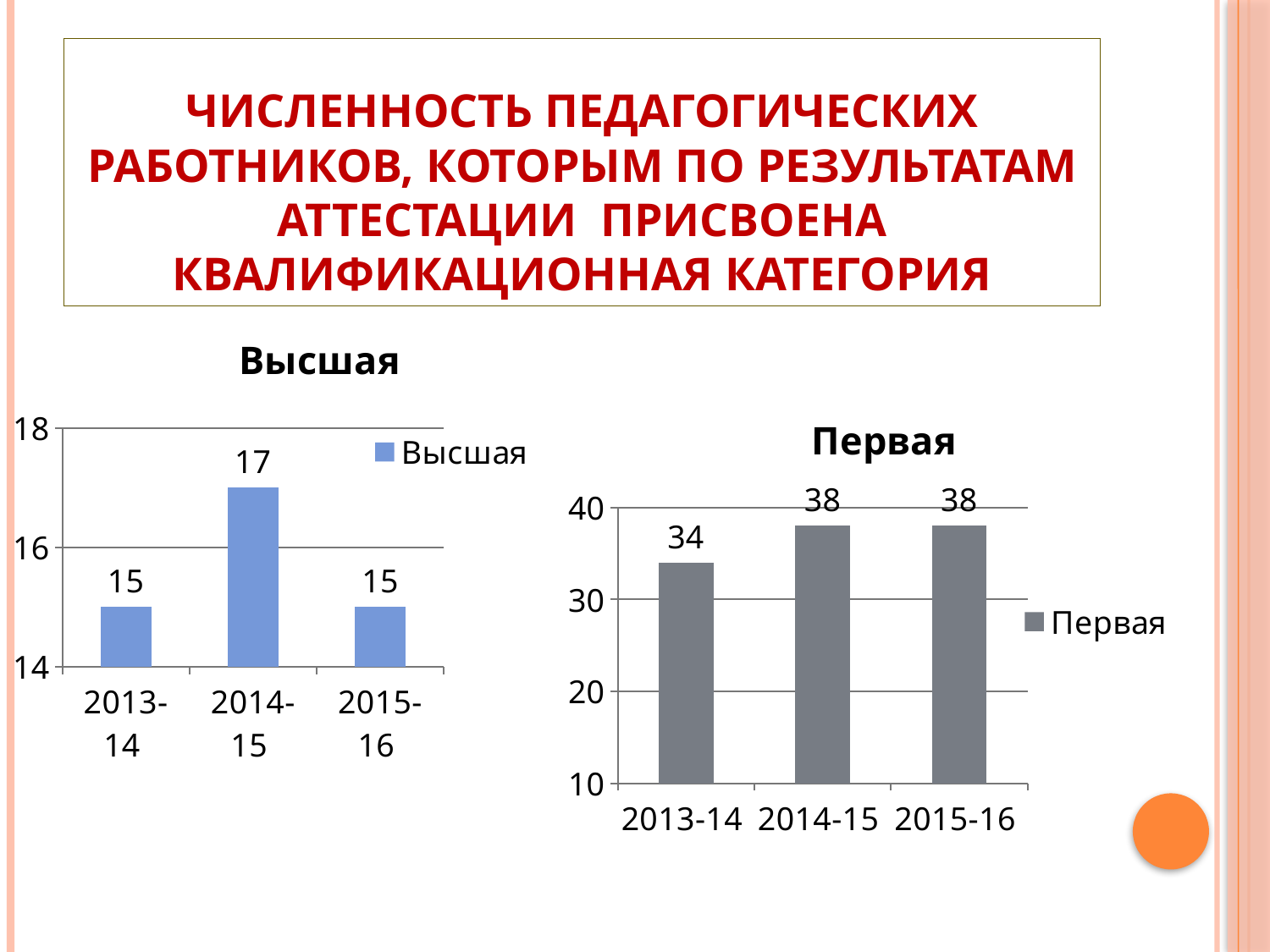
In the 'Первая' chart, which year has the lowest value? 2013-14 In the 'Высшая' chart, what is the difference between the values for 2014-15 and 2013-14? 2 In the 'Высшая' chart, what is the value for 2013-14? 15 In the 'Высшая' chart, which year has the highest value? 2014-15 What kind of chart is the 'Высшая' chart? bar chart How many series does the legend of the 'Первая' chart list? 1 In the 'Высшая' chart, what is the value for 2014-15? 17 How many categories are shown on the x axis of the 'Первая' chart? 3 In the 'Первая' chart, is the value for 2013-14 larger or smaller than the value for 2014-15? smaller In the 'Первая' chart, what is the value for 2015-16? 38 In the 'Первая' chart, what is the difference between the values for 2014-15 and 2013-14? 4 In the 'Первая' chart, what is the value for 2013-14? 34